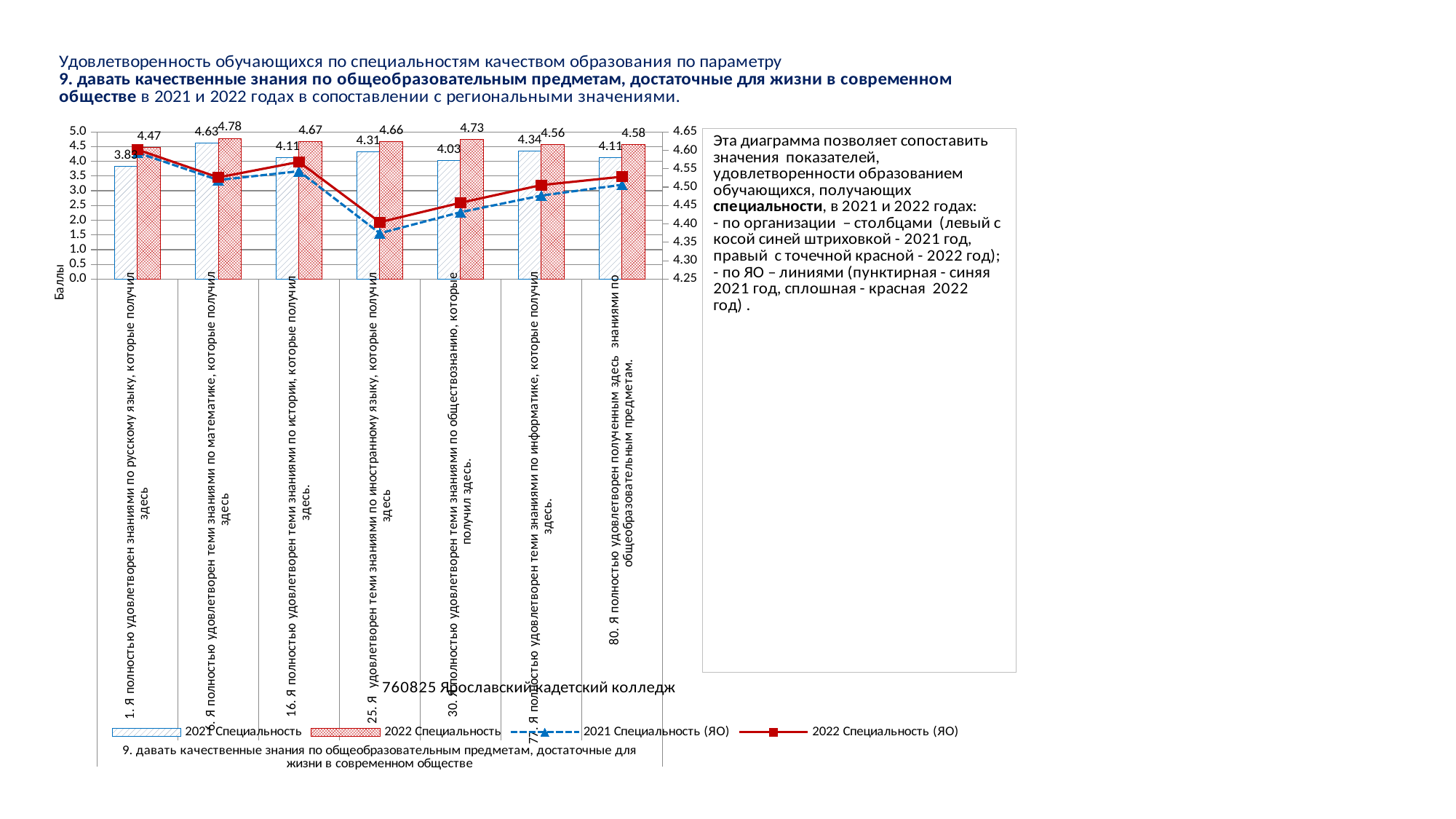
What is the value of the 2021 Специальность bar for item 9 (знаниями по математике)? 4.63 For item 1 (русскому языку), what is the difference between the 2022 Специальность and 2021 Специальность bars? 0.64 Which has the larger 2021 Специальность value: item 30 (обществознанию) or item 77 (информатике)? 77 (информатике), 4.34 What is the value of the 2022 Специальность bar for item 30 (знаниями по обществознанию)? 4.73 Which item has the highest 2022 Специальность bar? 9. Я полностью удовлетворен теми знаниями по математике, которые получил здесь (4.78) How many series does the chart legend list? 4 What is the value of the 2022 Специальность bar for item 1 (знаниями по русскому языку)? 4.47 For item 16 (истории), what is the difference between the 2022 Специальность and 2021 Специальность bars? 0.56 Which legend entry corresponds to the dashed blue line with triangle markers? 2021 Специальность (ЯО) How many items (categories) are shown on the x axis of the chart? 7 What kind of chart is shown on the slide? Combined bar and line chart Which item has the lowest 2021 Специальность bar? 1. Я полностью удовлетворен знаниями по русскому языку, которые получил здесь (3.83)